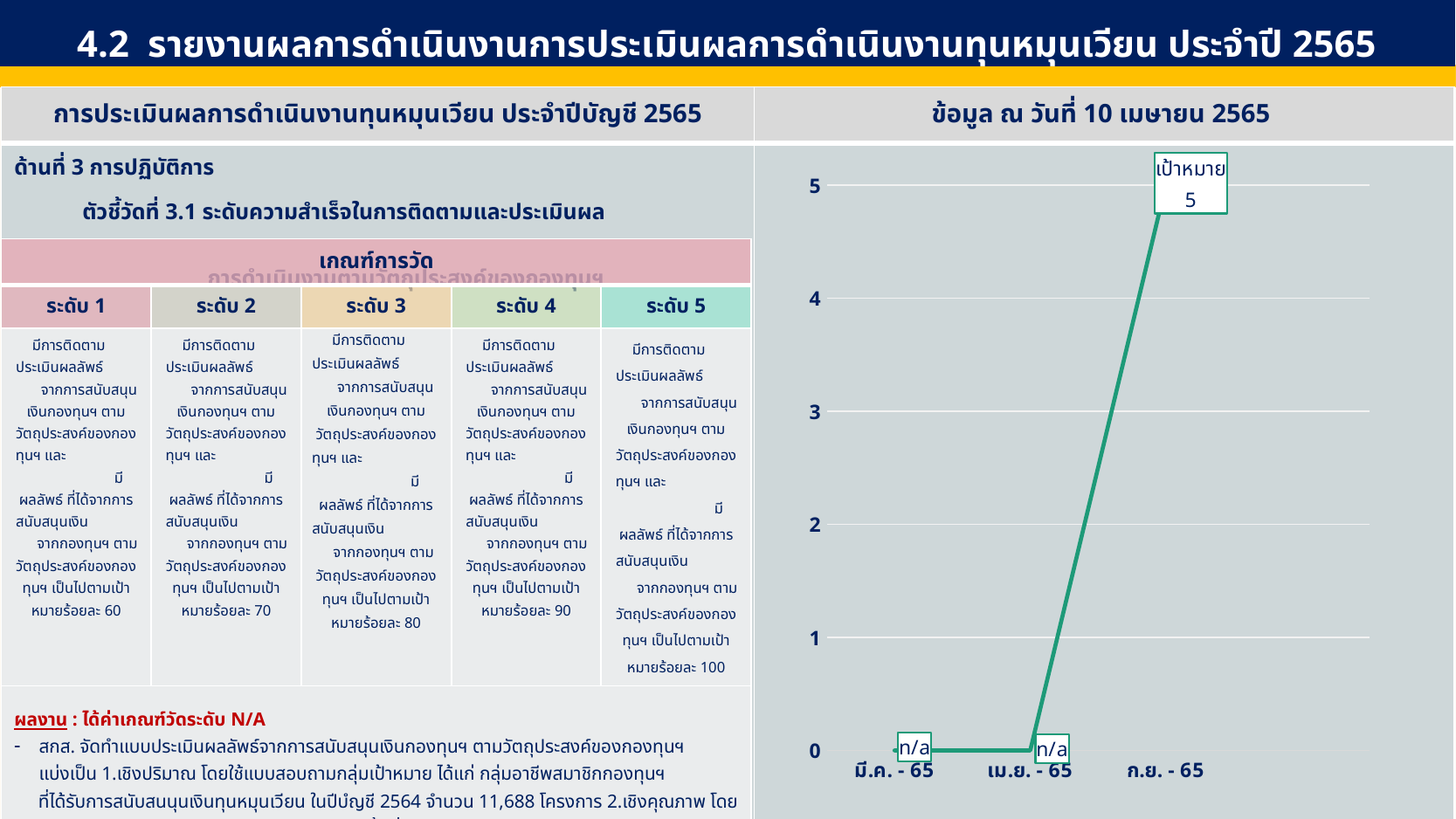
What is the data label shown for มี.ค. - 65 on the chart? n/a What word appears in the data label box above the ก.ย. - 65 point? เป้าหมาย Is the value for ก.ย. - 65 greater or less than 4? greater What kind of chart is shown on the right side of the slide? line chart What is the data label shown for เม.ย. - 65 on the chart? n/a Does the line on the chart rise or fall from เม.ย. - 65 to ก.ย. - 65? rise What is the highest tick value shown on the y axis of the chart? 5 Which is larger on the chart, the value for ก.ย. - 65 or the value plotted for เม.ย. - 65? ก.ย. - 65 What value is labelled for ก.ย. - 65 on the chart? 5 How many categories are shown on the x axis of the chart? 3 How many points on the chart are labelled n/a? 2 Which x-axis category has the highest plotted value on the chart? ก.ย. - 65